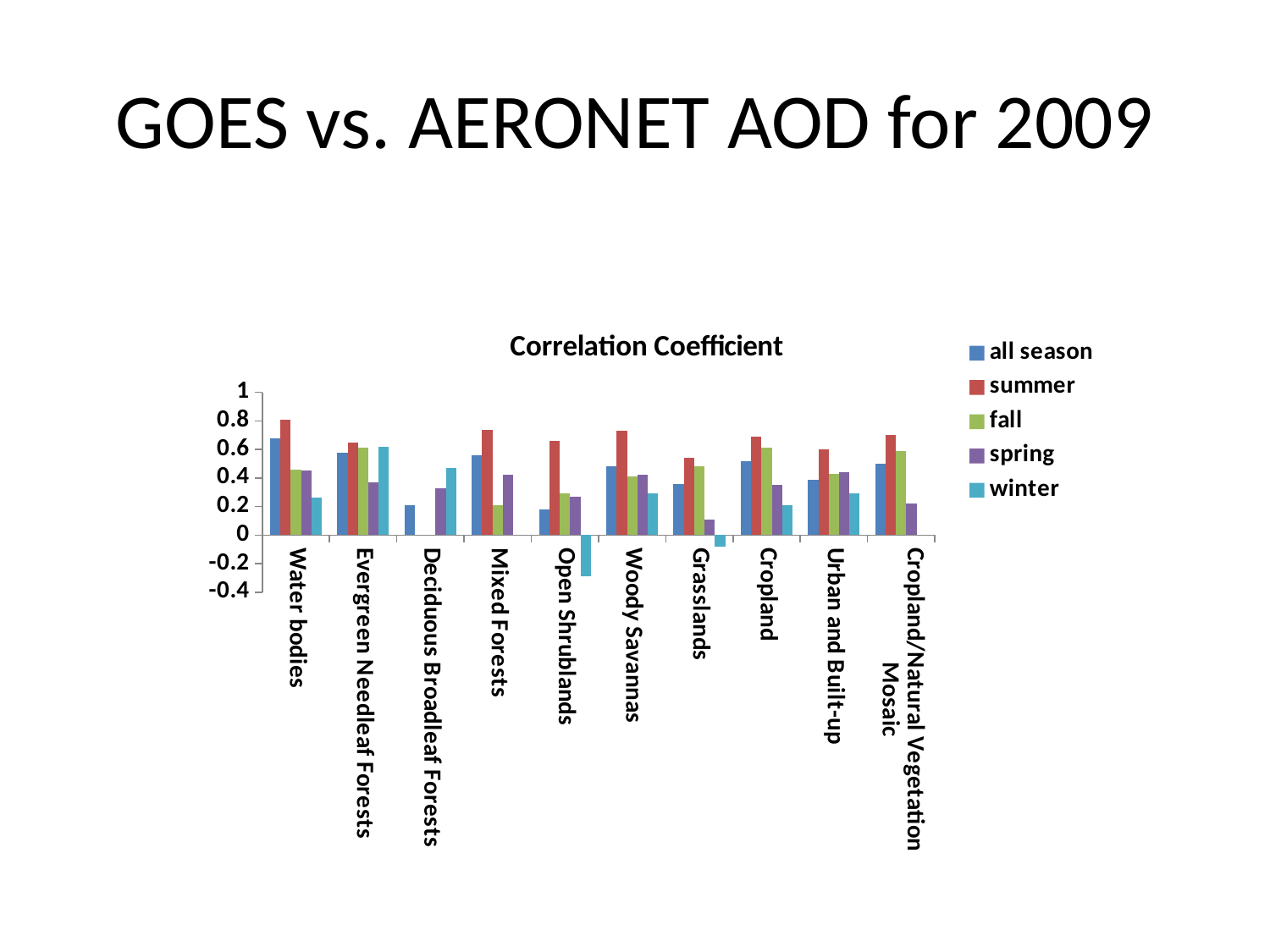
Which category has the lowest winter correlation coefficient? Open Shrublands For Deciduous Broadleaf Forests, which is larger, the winter value or the all season value? winter Is the winter value for Open Shrublands greater or less than 0? less Which is larger, the summer value for Water bodies or the summer value for Grasslands? Water bodies How many series does the legend of the Correlation Coefficient chart list? 5 What kind of chart is shown on the slide? bar chart Is the all season value for Water bodies greater or less than 0.6? greater What is the title of the chart? Correlation Coefficient Which category has the highest all season correlation coefficient? Water bodies Is the spring value for Grasslands greater or less than 0.2? less How many land cover categories are shown along the x axis of the chart? 10 Which category has the highest summer correlation coefficient? Water bodies